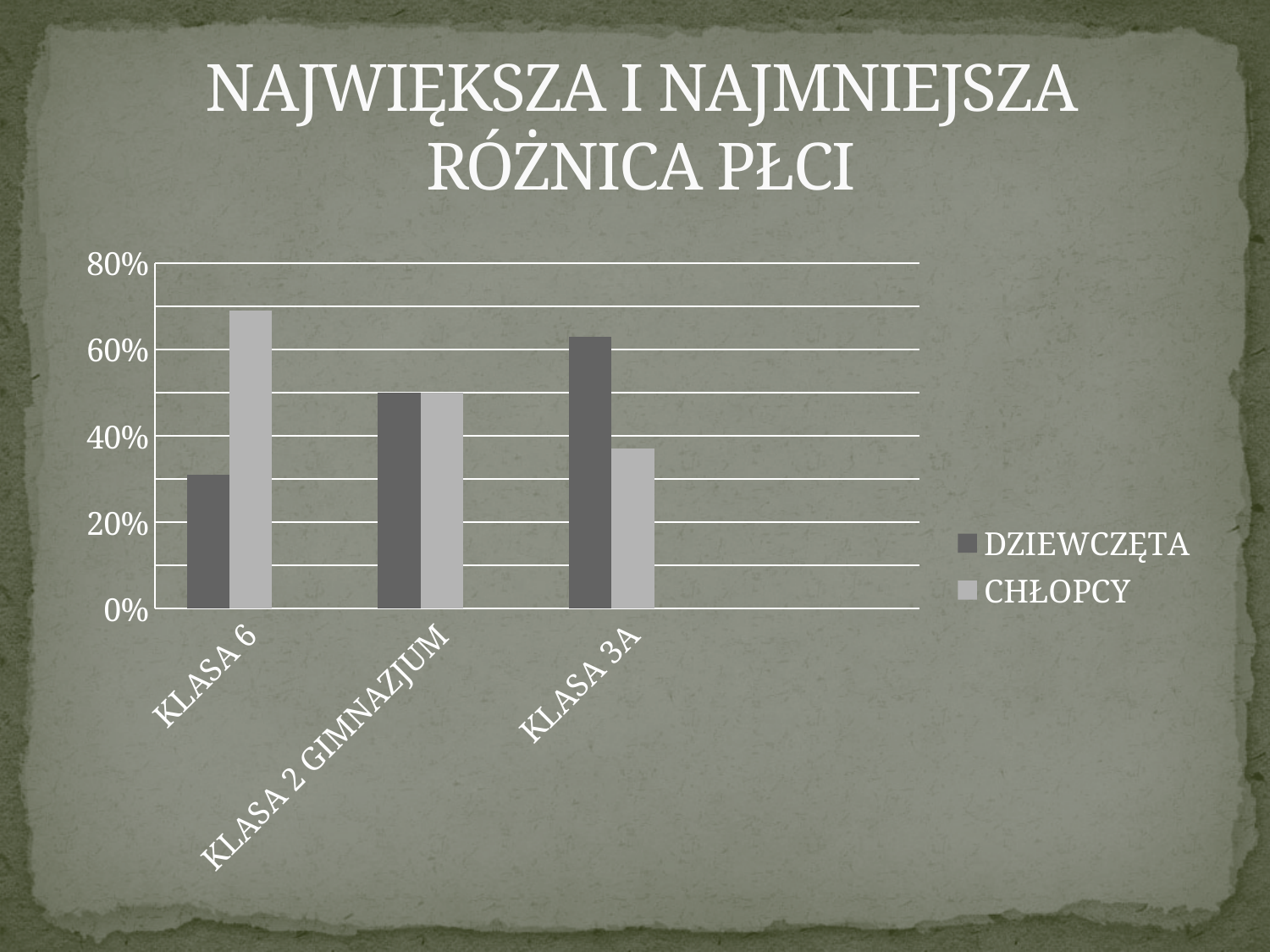
What kind of chart is shown on the slide? bar chart For KLASA 6, which series has the larger value, DZIEWCZĘTA or CHŁOPCY? CHŁOPCY How many series does the chart's legend list? 2 Is the CHŁOPCY value for KLASA 6 greater or less than 60%? greater Which category has the highest DZIEWCZĘTA value? KLASA 3A Which category has the highest CHŁOPCY value? KLASA 6 For KLASA 3A, which series has the larger value, DZIEWCZĘTA or CHŁOPCY? DZIEWCZĘTA Is the DZIEWCZĘTA value for KLASA 6 greater or less than 40%? less Which category has the lowest DZIEWCZĘTA value? KLASA 6 Which category has the lowest CHŁOPCY value? KLASA 3A What is the title of the chart on the slide? NAJWIĘKSZA I NAJMNIEJSZA RÓŻNICA PŁCI How many categories are shown on the x axis of the chart? 3